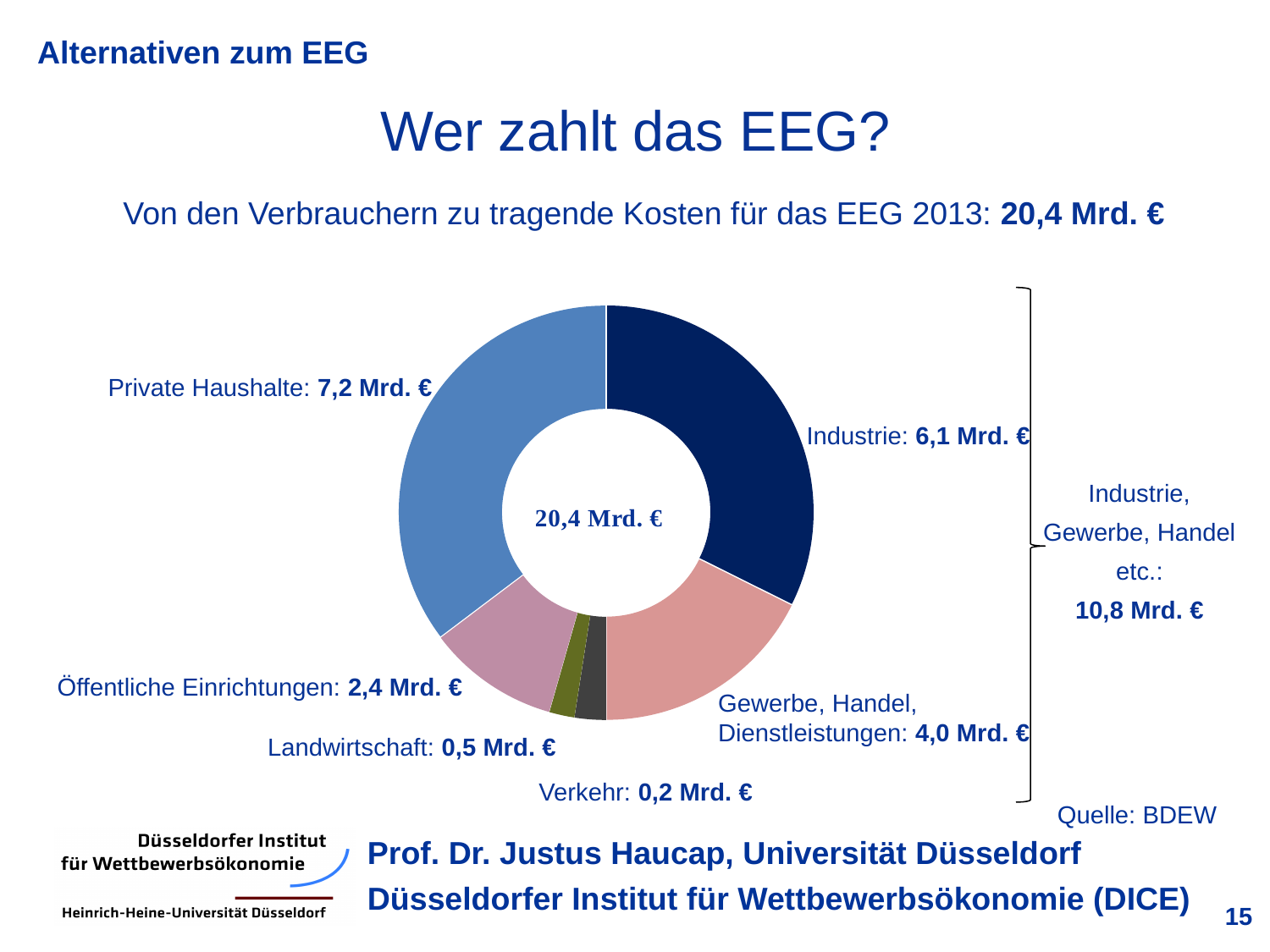
How many categories does the chart show? 6 What total value is printed in the centre of the chart? 20,4 Mrd. € What is the value for Industrie? 6,1 Mrd. € What is the difference between Gewerbe, Handel, Dienstleistungen and Öffentliche Einrichtungen? 1,6 Mrd. € What is the value for Private Haushalte? 7,2 Mrd. € What is the value for Gewerbe, Handel, Dienstleistungen? 4,0 Mrd. € Which category has the largest share of the chart? Private Haushalte What is the difference between Private Haushalte and Industrie? 1,1 Mrd. € Which category has the smallest share of the chart? Verkehr What kind of chart is shown on the slide? Pie (donut) chart What is the value for Landwirtschaft? 0,5 Mrd. € Which is larger, Öffentliche Einrichtungen or Landwirtschaft? Öffentliche Einrichtungen